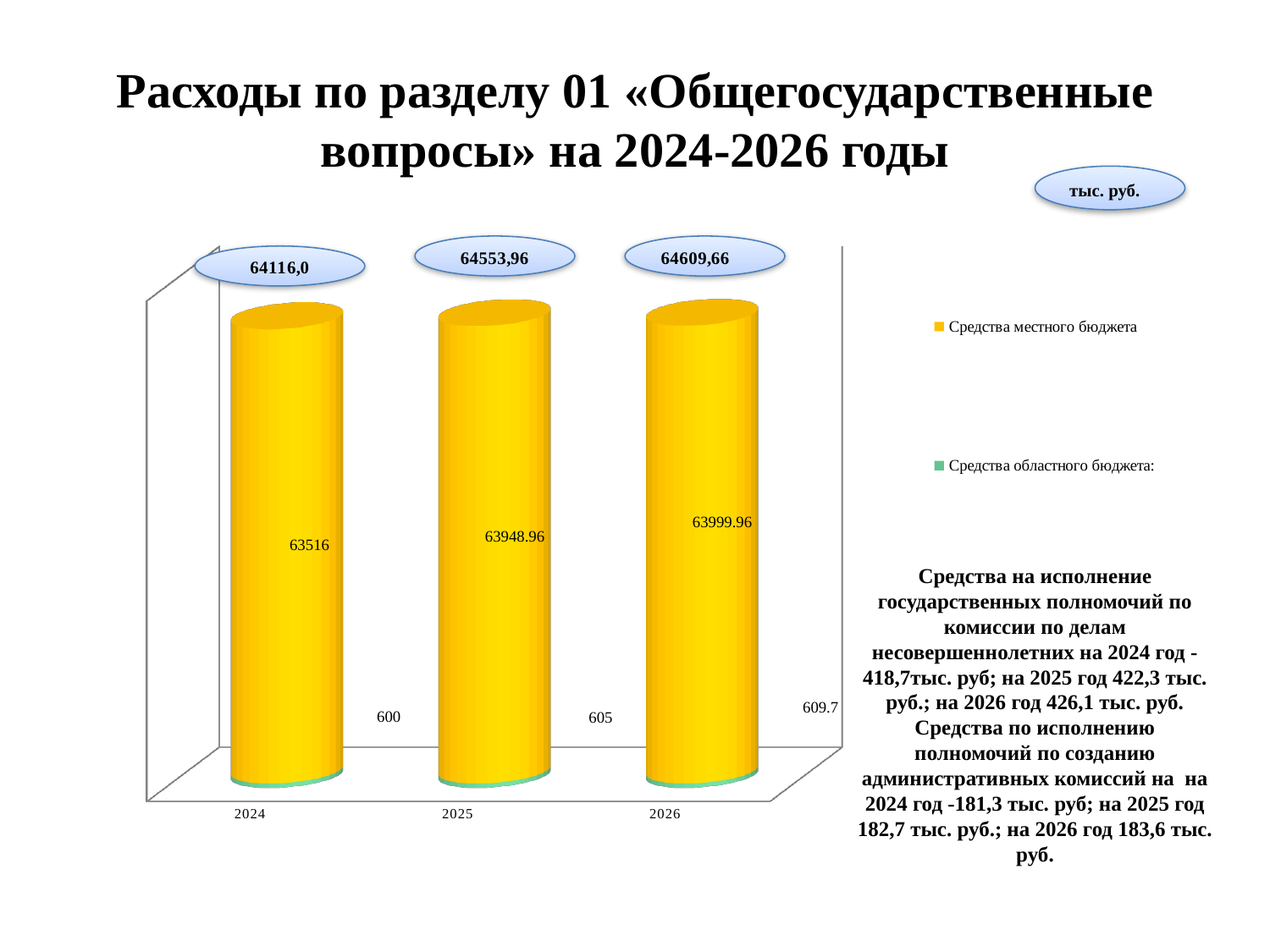
What is the value for Средства областного бюджета in 2026? 609.7 How many series does the legend list? 2 Do the values for Средства местного бюджета rise or fall from 2024 to 2026? rise What is the value for Средства местного бюджета in 2025? 63948.96 What is the value for Средства местного бюджета in 2024? 63516 In which year is Средства местного бюджета the lowest? 2024 What is the difference between Средства областного бюджета in 2025 and in 2024? 5 What kind of chart is shown on the slide? bar chart In which year is Средства областного бюджета the highest? 2026 What is the difference between Средства местного бюджета in 2025 and in 2024? 432.96 What is the value for Средства областного бюджета in 2024? 600 What is the total of the stacked bar for 2025, as shown on the slide? 64553,96